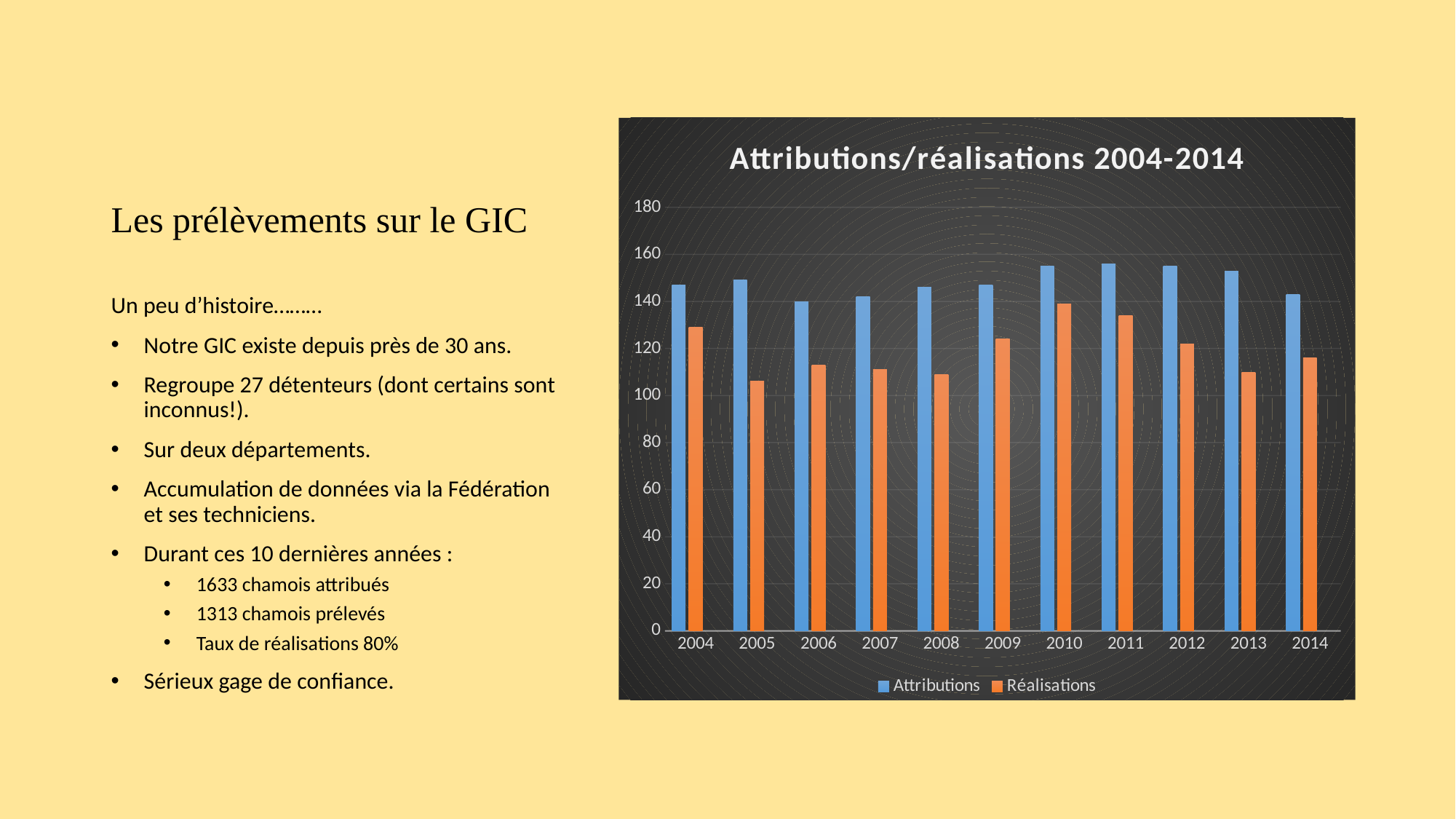
What kind of chart is shown on the slide? Bar chart What is the title of the chart? Attributions/réalisations 2004-2014 Is the value for Attributions in 2010 greater or less than 140? greater Is the value for Réalisations in 2005 greater or less than 120? less Which colour represents the Réalisations series in the chart? Orange Is the value for Réalisations in 2004 greater or less than 120? greater How many series does the chart legend list? 2 Which year has the larger Réalisations value, 2010 or 2013? 2010 In which year is the Réalisations value highest? 2010 In 2004, which series has the larger value, Attributions or Réalisations? Attributions How many years are shown on the x axis of the chart? 11